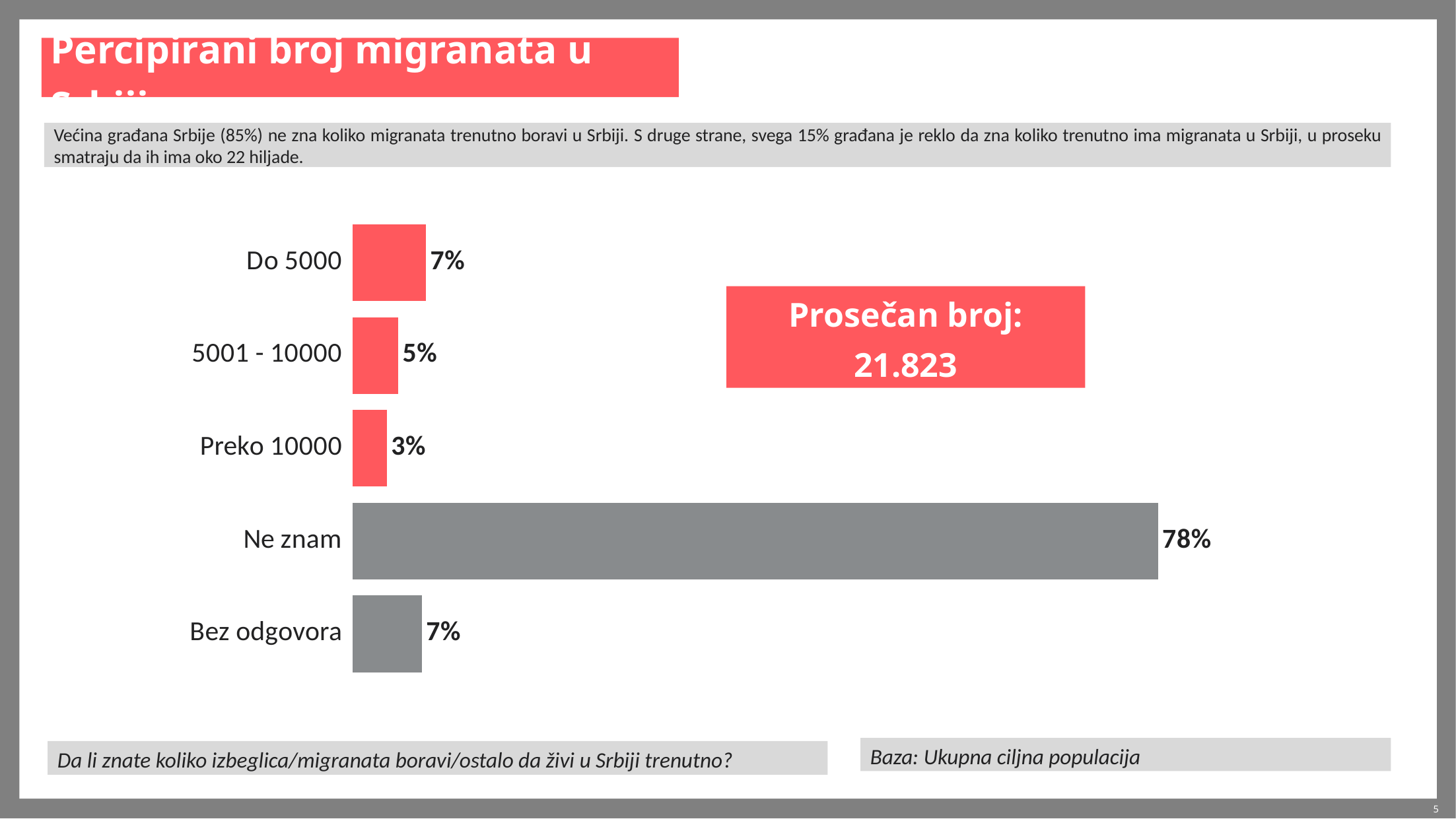
What is the value for "Do 5000"? 7% Which category has the lowest value? Preko 10000 What is the value for "Bez odgovora"? 7% Which category has the highest value? Ne znam What is the value for "5001 - 10000"? 5% What kind of chart is shown on the slide? Bar chart What is the difference between the values for "Ne znam" and "Bez odgovora"? 71% How many categories are shown in the chart? 5 What average number (Prosečan broj) is shown in the box next to the chart? 21.823 What is the value for "Ne znam"? 78% Which is larger, the value for "5001 - 10000" or the value for "Preko 10000"? 5001 - 10000 What is the value for "Preko 10000"? 3%